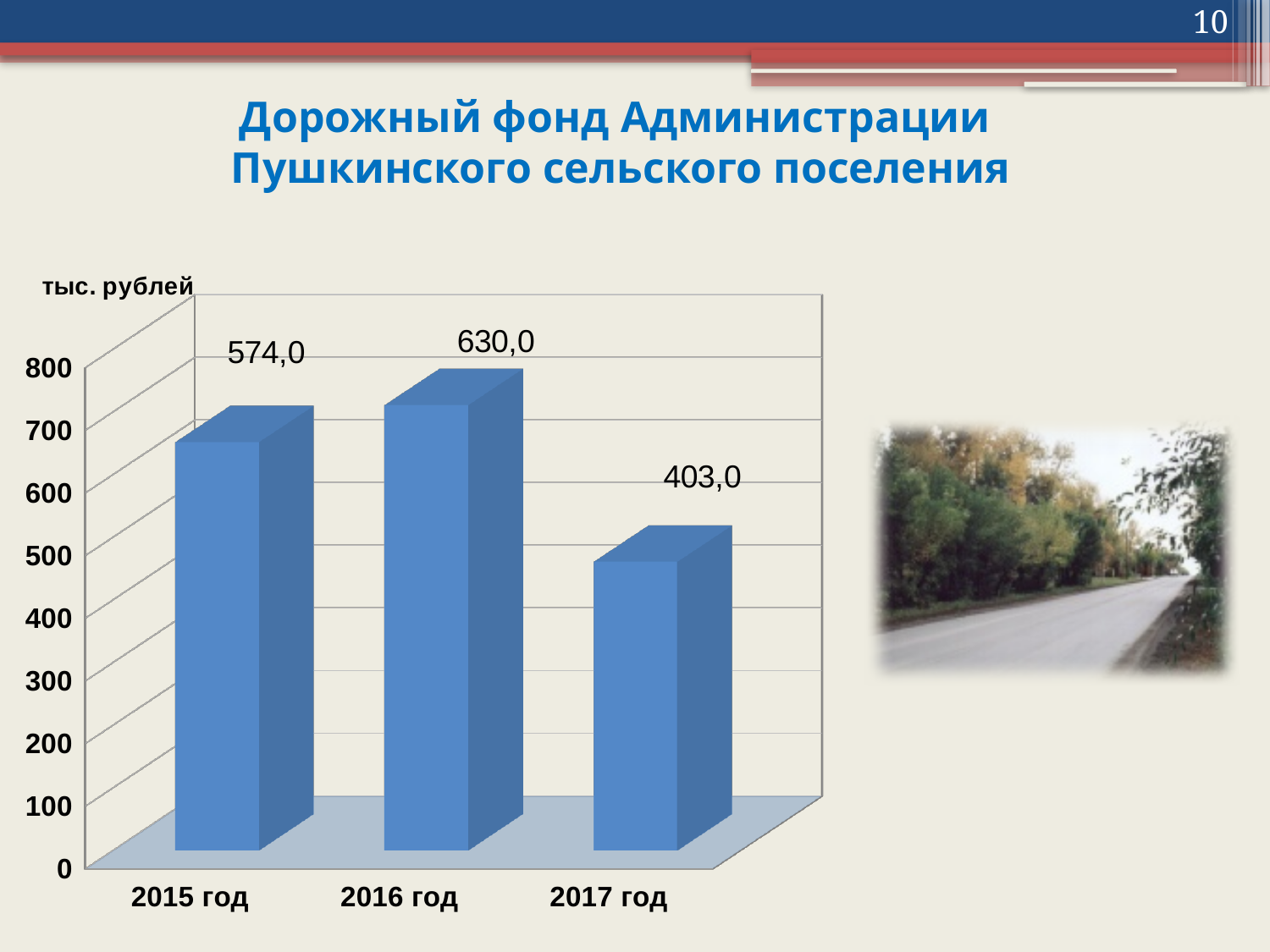
What is the difference between the values for 2016 год and 2017 год? 227,0 What is the value for 2015 год? 574,0 Which is larger, the value for 2015 год or the value for 2017 год? 2015 год What kind of chart is shown on the slide? bar chart What unit is indicated above the vertical axis of the chart? тыс. рублей Which year has the highest value? 2016 год How many years are shown on the chart? 3 Which year has the lowest value? 2017 год What is the title of the slide containing the chart? Дорожный фонд Администрации Пушкинского сельского поселения What is the value for 2017 год? 403,0 What is the value for 2016 год? 630,0 What is the difference between the values for 2016 год and 2015 год? 56,0